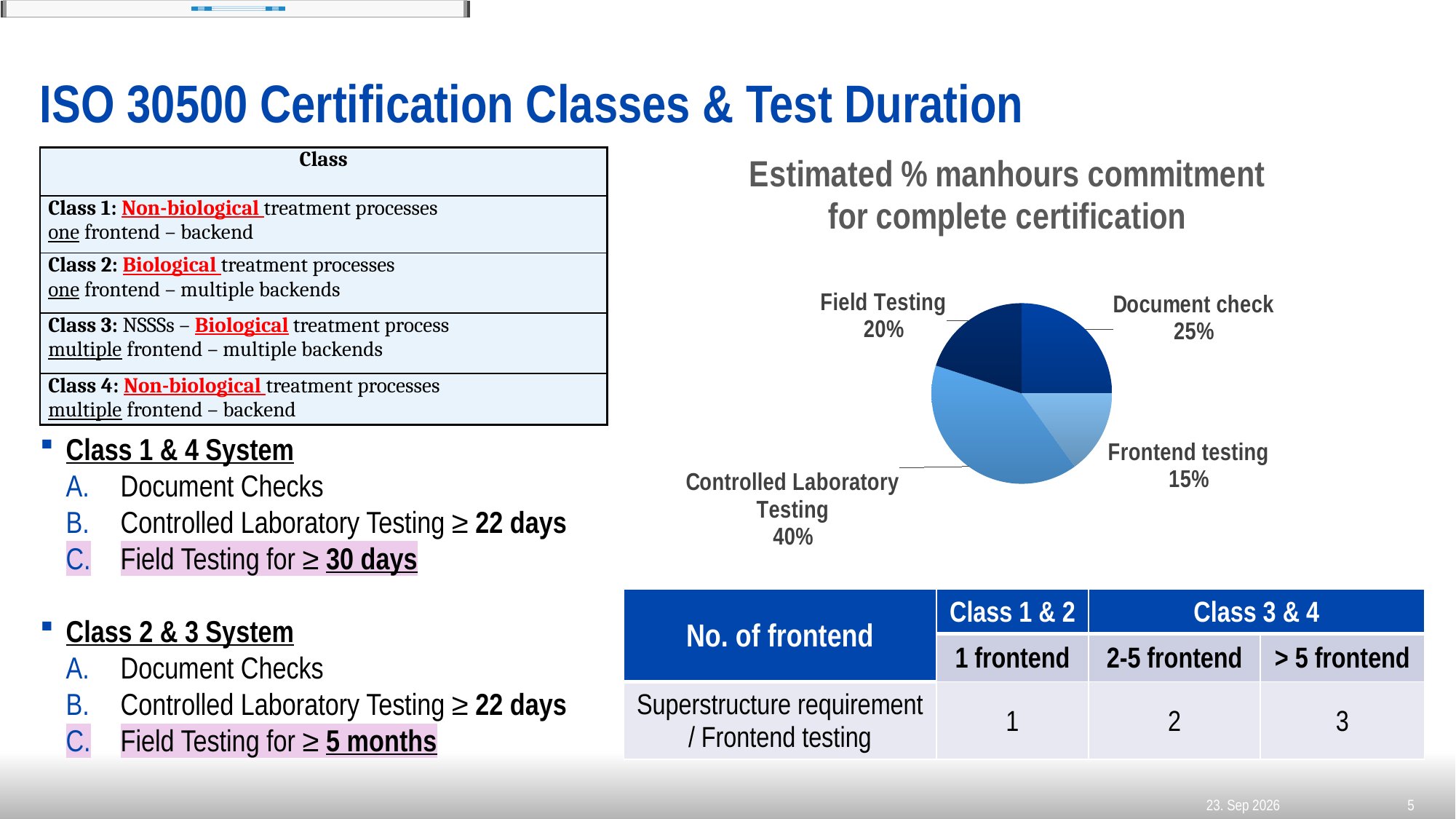
What is the difference in percentage points between Controlled Laboratory Testing and Document check? 15 What percentage of manhours is attributed to Controlled Laboratory Testing? 40% Which category has the largest share of the pie? Controlled Laboratory Testing What percentage of manhours is attributed to Document check? 25% Which category has the smallest share of the pie? Frontend testing What is the title of the chart? Estimated % manhours commitment for complete certification How many categories are shown in the pie chart? 4 What type of chart is shown on the slide? pie chart Which is larger, the share for Field Testing or the share for Frontend testing? Field Testing What percentage of manhours is attributed to Frontend testing? 15% What is the difference in percentage points between Document check and Field Testing? 5 What percentage of manhours is attributed to Field Testing? 20%